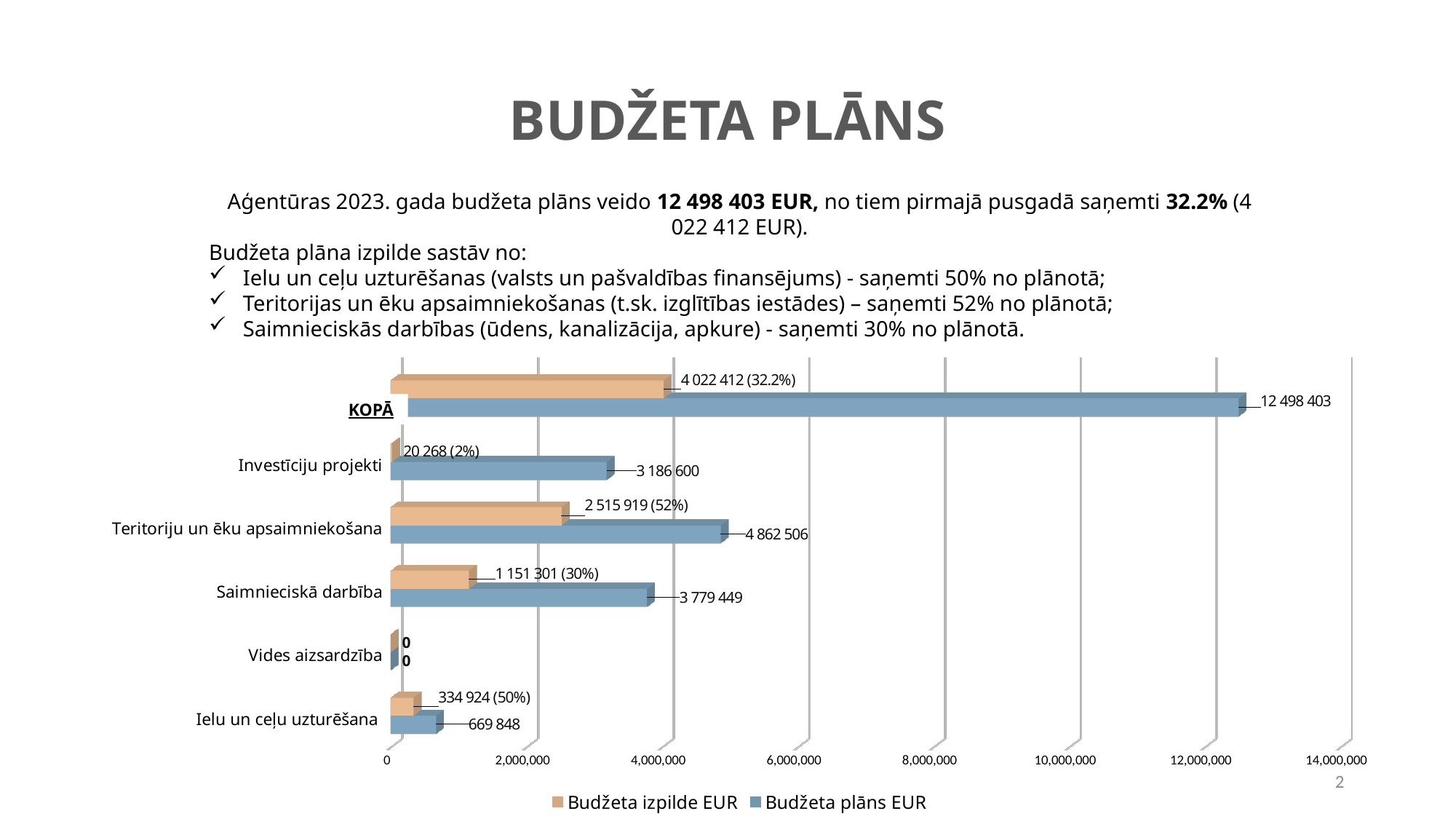
Which category has the highest Budžeta plāns EUR value? KOPĀ What is the difference between Budžeta plāns EUR and Budžeta izpilde EUR for Teritoriju un ēku apsaimniekošana? 2 346 587 Which category has the lowest Budžeta plāns EUR value? Vides aizsardzība Is the Budžeta plāns EUR value for Saimnieciskā darbība greater or less than 4,000,000? less What is the Budžeta plāns EUR value for KOPĀ? 12 498 403 What is the value of Budžeta izpilde EUR for Saimnieciskā darbība? 1 151 301 (30%) What is the Budžeta izpilde EUR value for Ielu un ceļu uzturēšana? 334 924 (50%) What kind of chart is shown on the slide? bar chart Which is larger: the Budžeta plāns EUR value for Investīciju projekti or for Saimnieciskā darbība? Saimnieciskā darbība How many series does the legend list? 2 What is the value of Budžeta plāns EUR for Teritoriju un ēku apsaimniekošana? 4 862 506 How many categories are shown on the chart? 6